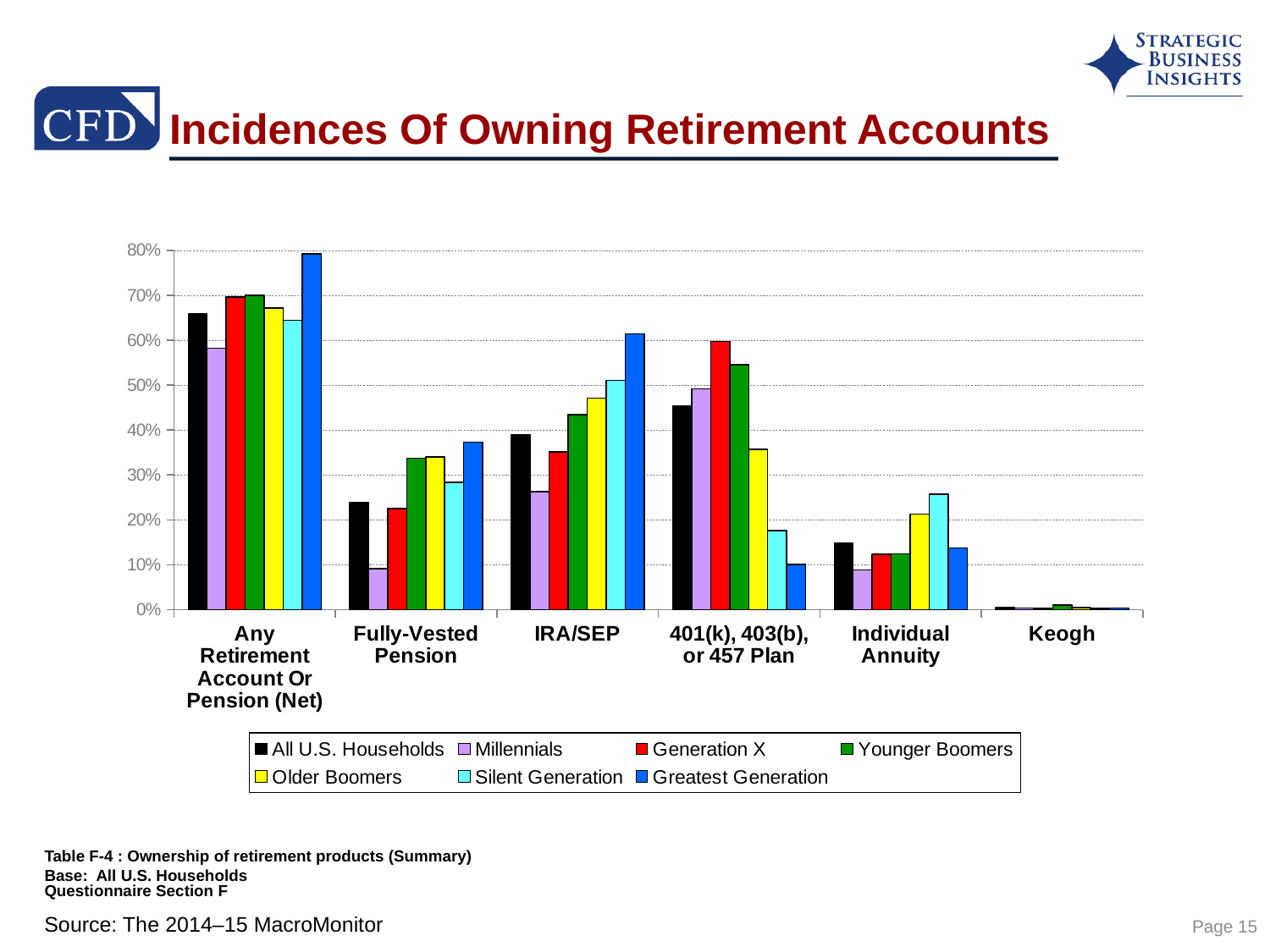
How many series does the legend list? 7 Is the value for Greatest Generation in Any Retirement Account Or Pension (Net) greater or less than 70%? greater Which category has the lowest values across all series? Keogh Which series has the highest bar for Any Retirement Account Or Pension (Net)? Greatest Generation Which series has the highest bar for 401(k), 403(b), or 457 Plan? Generation X How many retirement account categories are shown along the x axis? 6 Is the value for Greatest Generation in 401(k), 403(b), or 457 Plan greater or less than 20%? less What kind of chart is shown on the slide? bar chart For Individual Annuity, which is larger: Silent Generation or Greatest Generation? Silent Generation Which series has the highest bar for IRA/SEP? Greatest Generation Which series has the lowest bar for Fully-Vested Pension? Millennials Is the value for Millennials in Fully-Vested Pension greater or less than 20%? less